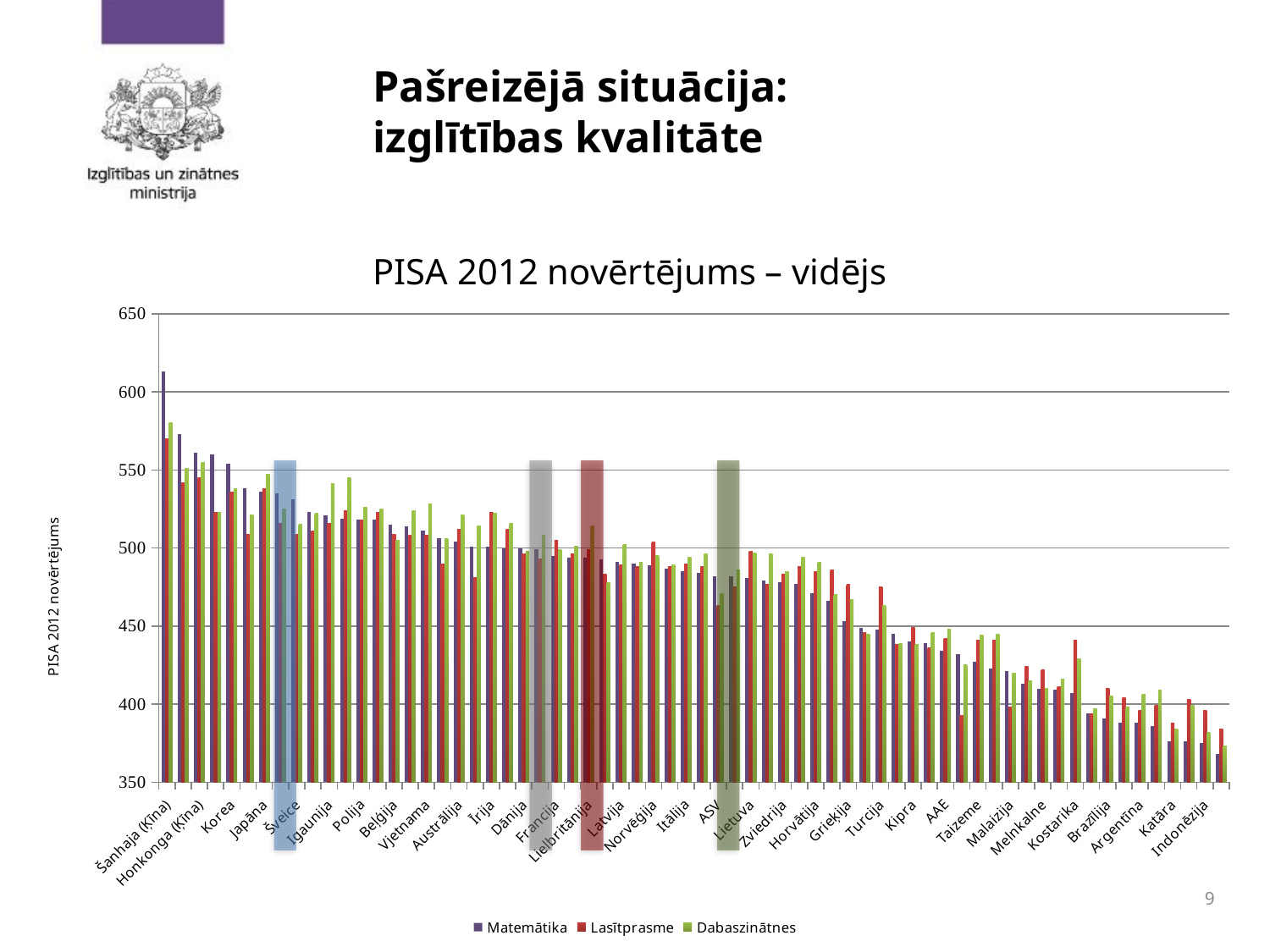
Which is larger for Šanhaja (Ķīna): the Matemātika value or the Lasītprasme value? Matemātika What is the title of the chart? PISA 2012 novērtējums – vidējs Is the Matemātika value for Latvija greater or less than 500? less How many series does the legend of the chart list? 3 Do the Matemātika values generally rise or fall moving from left to right along the x axis? fall Is the Matemātika value for Šanhaja (Ķīna) greater or less than 600? greater Is the Matemātika value for Japāna greater or less than 500? greater Which country has the highest Matemātika value in the chart? Šanhaja (Ķīna) What are the three series named in the chart legend? Matemātika, Lasītprasme, Dabaszinātnes What kind of chart is shown on the slide? bar chart